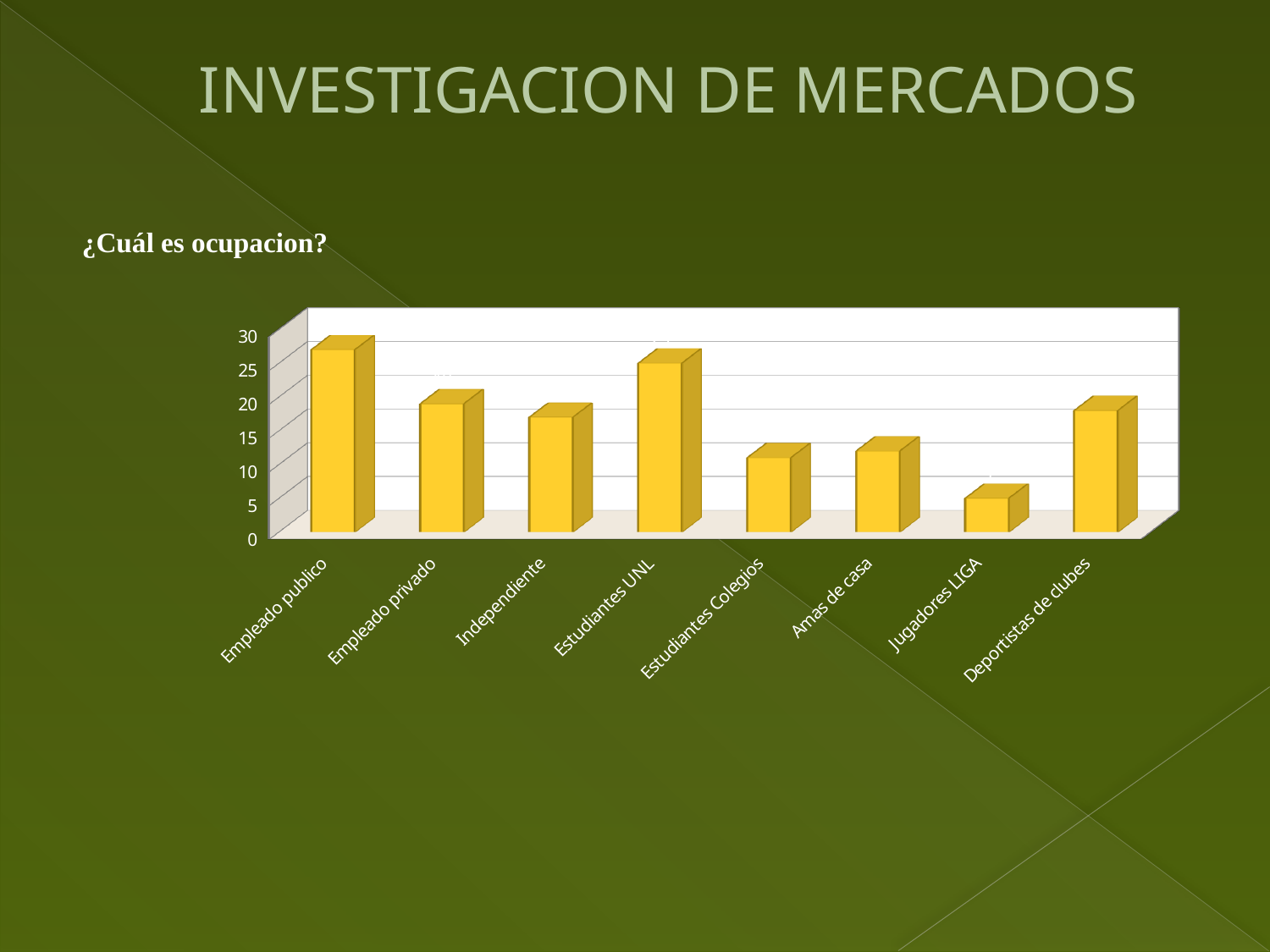
What kind of chart is shown on the slide? bar chart Is the value for Jugadores LIGA greater or less than 10? less Which occupation category has the highest bar? Empleado publico Is the value for Empleado privado greater or less than 25? less Is the value for Amas de casa greater or less than 15? less Which is larger, the value for Estudiantes UNL or the value for Estudiantes Colegios? Estudiantes UNL What question is the chart answering, as written above it? ¿Cuál es ocupacion? Which occupation category has the lowest bar? Jugadores LIGA How many occupation categories are plotted on the chart? 8 Which is larger, the value for Empleado privado or the value for Amas de casa? Empleado privado